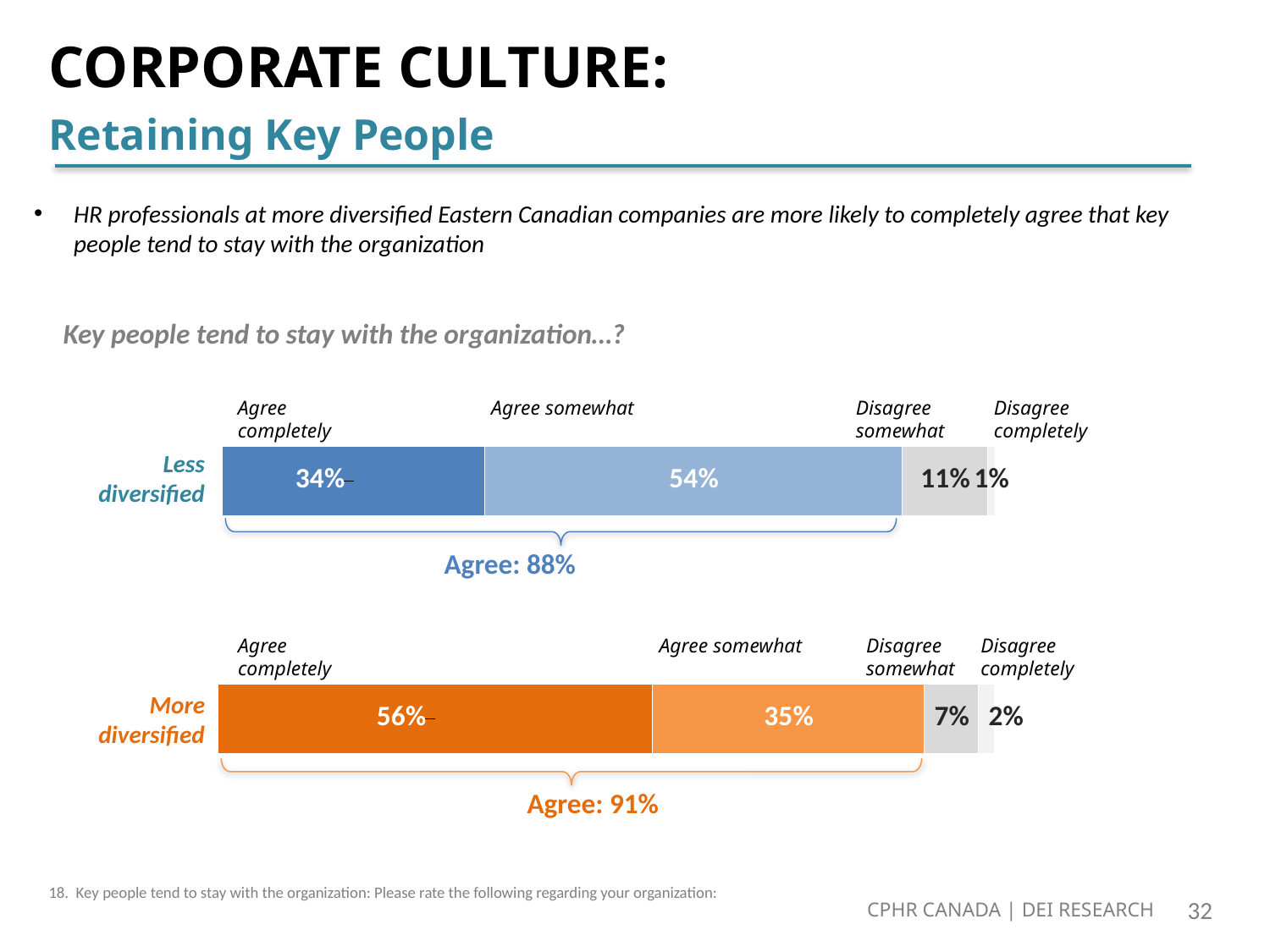
What is the combined 'Agree' percentage shown for the 'Less diversified' bar? 88% What is the combined 'Agree' percentage shown for the 'More diversified' bar? 91% How many response categories are shown in each bar? 4 In the 'Less diversified' bar, what percentage agree somewhat? 54% What type of chart is used to show the responses on this slide? Stacked bar chart Which group has a higher 'Disagree somewhat' percentage, 'Less diversified' or 'More diversified'? Less diversified Which response category is the smallest in the 'More diversified' bar? Disagree completely In the 'More diversified' bar, what percentage disagree somewhat? 7% What is the difference in the 'Agree completely' percentage between the 'More diversified' and 'Less diversified' bars? 22 percentage points Which response category is the largest in the 'Less diversified' bar? Agree somewhat In the 'More diversified' bar, what percentage of respondents agree completely? 56% In the 'Less diversified' bar, what percentage of respondents agree completely that key people tend to stay with the organization? 34%